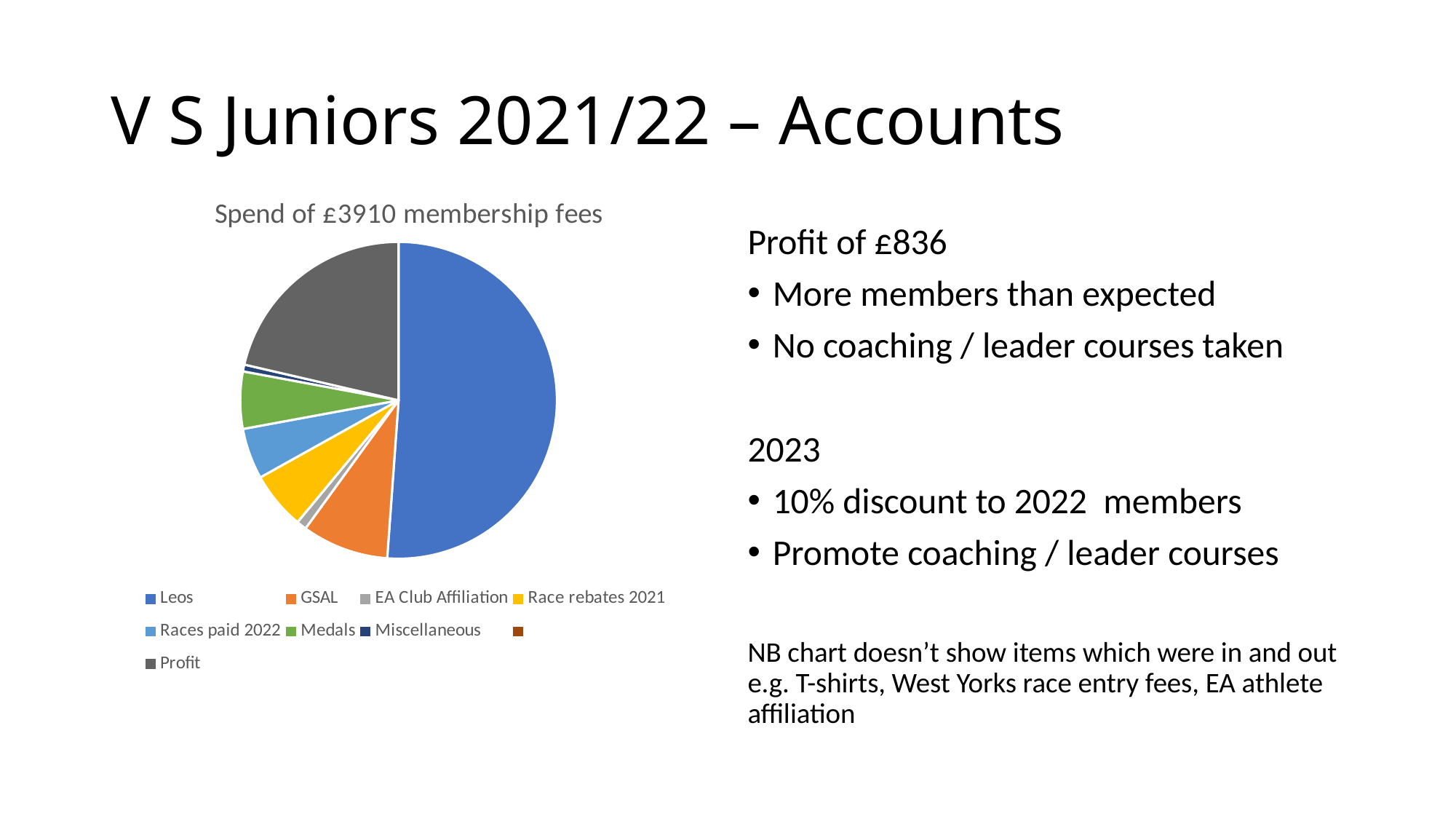
Which slice is larger, Leos or Profit? Leos Which labelled category has the smallest slice of the pie chart? Miscellaneous How many legend entries in the pie chart have a readable label? 8 What colour is the Leos slice in the pie chart? blue What total amount of membership fees does the pie chart represent, according to its title? £3910 Which category has the largest slice of the pie chart? Leos Which slice is larger, Races paid 2022 or Miscellaneous? Races paid 2022 What kind of chart is shown on the slide? pie chart Which slice is larger, Race rebates 2021 or EA Club Affiliation? Race rebates 2021 What is the title of the pie chart? Spend of £3910 membership fees